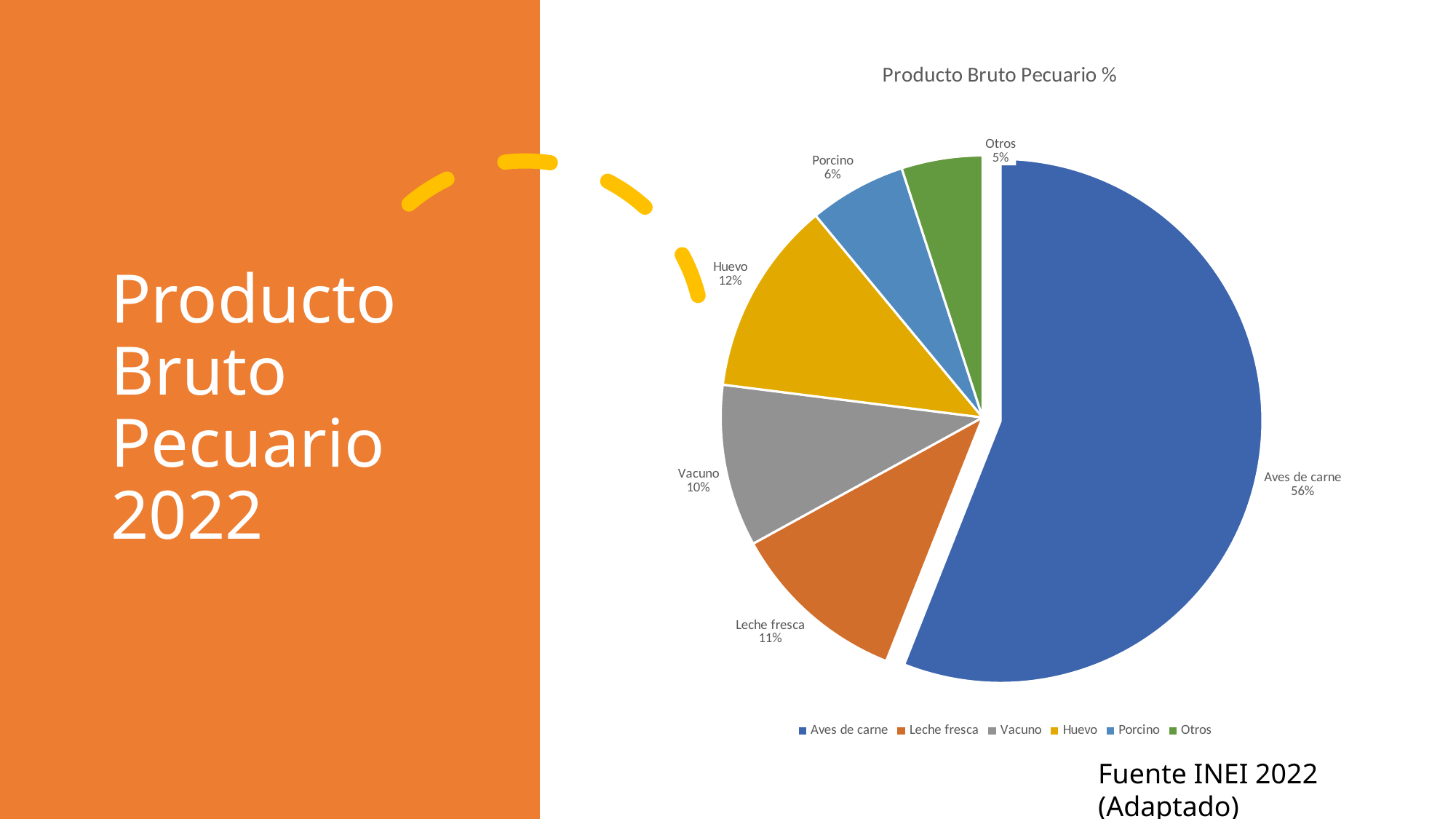
What is the difference between the values for Aves de carne and Huevo? 44% Which slice is separated (exploded) from the rest of the pie? Aves de carne What is the title of the chart? Producto Bruto Pecuario % What is the value shown for Porcino? 6% Which category has the largest slice of the pie? Aves de carne What kind of chart is shown on the slide? pie chart What is the value shown for Leche fresca? 11% What is the value shown for Huevo? 12% Which category has the smallest slice of the pie? Otros How many slices does the pie chart have? 6 What share of the pie does Aves de carne have? 56% Which is larger, the value for Vacuno or the value for Huevo? Huevo